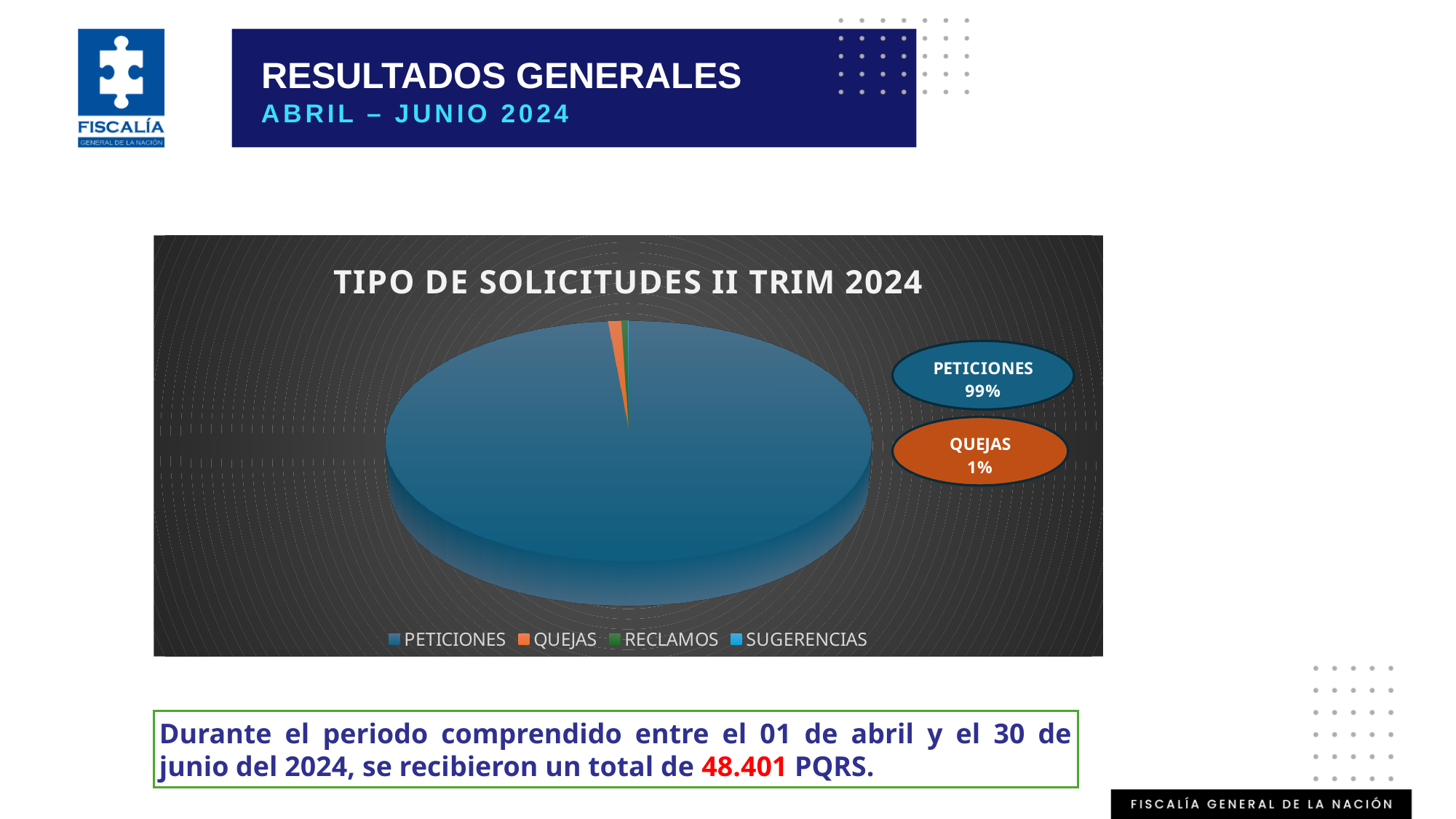
What is the difference between the share for PETICIONES and the share for QUEJAS? 98% What colour is the PETICIONES slice in the pie chart? blue What is the title of the chart? TIPO DE SOLICITUDES II TRIM 2024 What kind of chart is shown on the slide? pie chart Is the share for PETICIONES greater or less than 50%? greater How many categories does the chart's legend list? 4 What share of the pie does PETICIONES represent? 99% What share of the pie does QUEJAS represent? 1% Which is larger, the share for PETICIONES or the share for QUEJAS? PETICIONES Which category has the largest slice of the pie? PETICIONES Is the share for QUEJAS greater or less than 10%? less